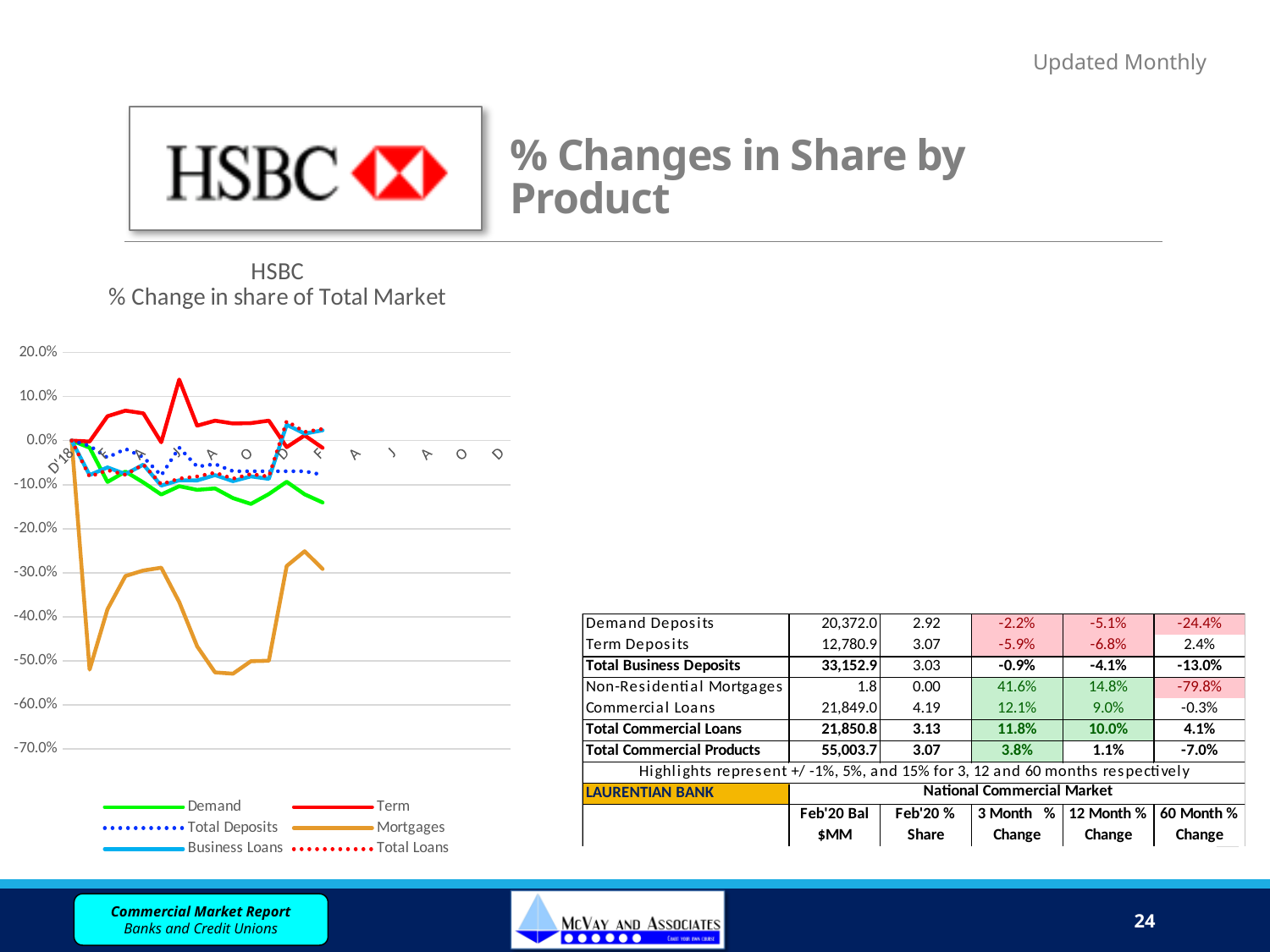
Which series reaches the lowest value on the chart? Mortgages At the end of the plotted period, which series is higher: Term or Mortgages? Term What kind of chart is shown on the slide? line chart Which series in the chart is drawn in orange? Mortgages How many series does the chart's legend list? 6 Is the highest value of the Term series greater or less than 10.0%? greater What is the lowest value shown on the chart's vertical axis? -70.0% What is the title of the chart? HSBC % Change in share of Total Market Which series reaches the highest value on the chart? Term Is the lowest value of the Mortgages series greater or less than -40.0%? less Does the Demand series overall rise or fall from the start of the plotted period to its end? fall Is the value of the Demand series at the end of the plotted period greater or less than 0.0%? less